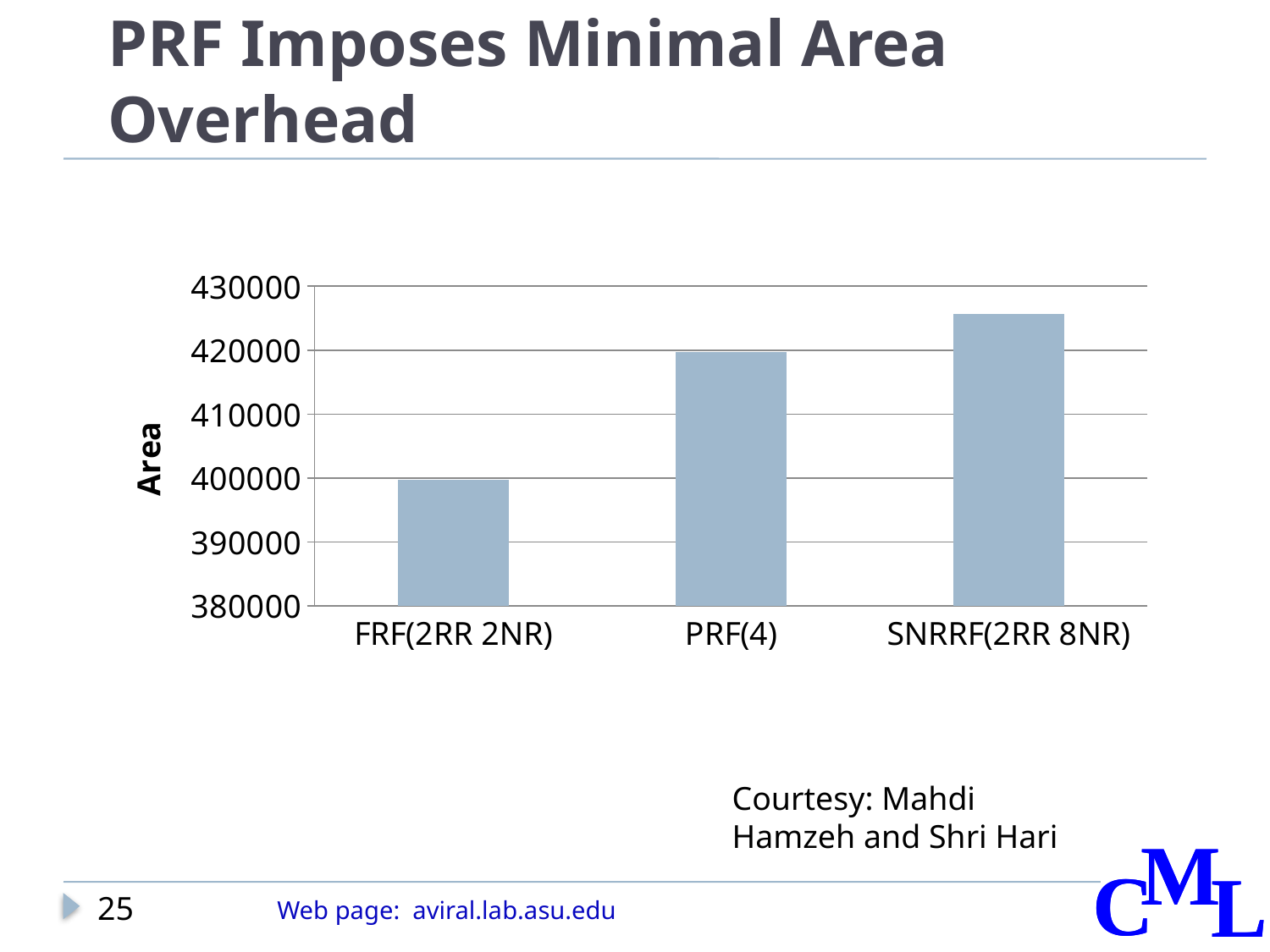
Is the value for FRF(2RR 2NR) greater or less than 390000? greater Do the bar values rise or fall from left to right along the x axis? rise Which category has the lowest area? FRF(2RR 2NR) What kind of chart is shown on the slide? bar chart How many categories are plotted on the x axis? 3 What is the label on the vertical axis of the chart? Area Is the value for SNRRF(2RR 8NR) greater or less than 420000? greater Which has the larger area, PRF(4) or SNRRF(2RR 8NR)? SNRRF(2RR 8NR) Is the value for PRF(4) greater or less than 410000? greater Which category has the highest area? SNRRF(2RR 8NR) Which has the larger area, PRF(4) or FRF(2RR 2NR)? PRF(4)